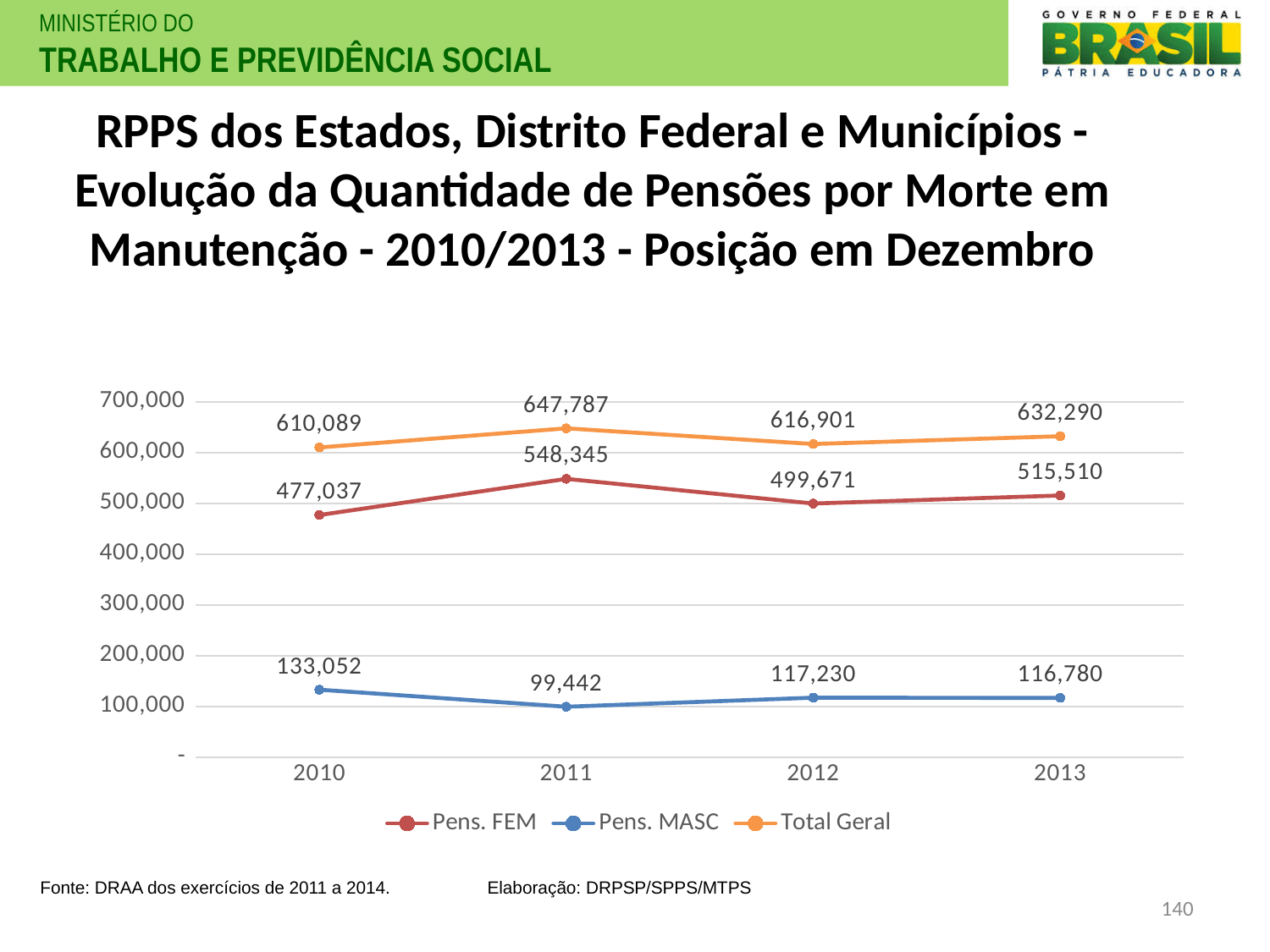
By how much did Pens. FEM increase from 2010 to 2011? 71,308 Is the value for Pens. FEM in 2010 greater or less than 500,000? less Which is larger, Pens. FEM in 2012 or Pens. FEM in 2013? Pens. FEM in 2013 What is the value of Pens. MASC in 2012? 117,230 How many years are plotted on the x axis? 4 What is the value of Pens. FEM in 2013? 515,510 What is the difference between Total Geral in 2011 and in 2012? 30,886 In which year is Total Geral highest? 2011 What type of chart is shown on the slide? Line chart What is the value of Total Geral in 2011? 647,787 How many series does the legend list? 3 In which year is Pens. MASC lowest? 2011